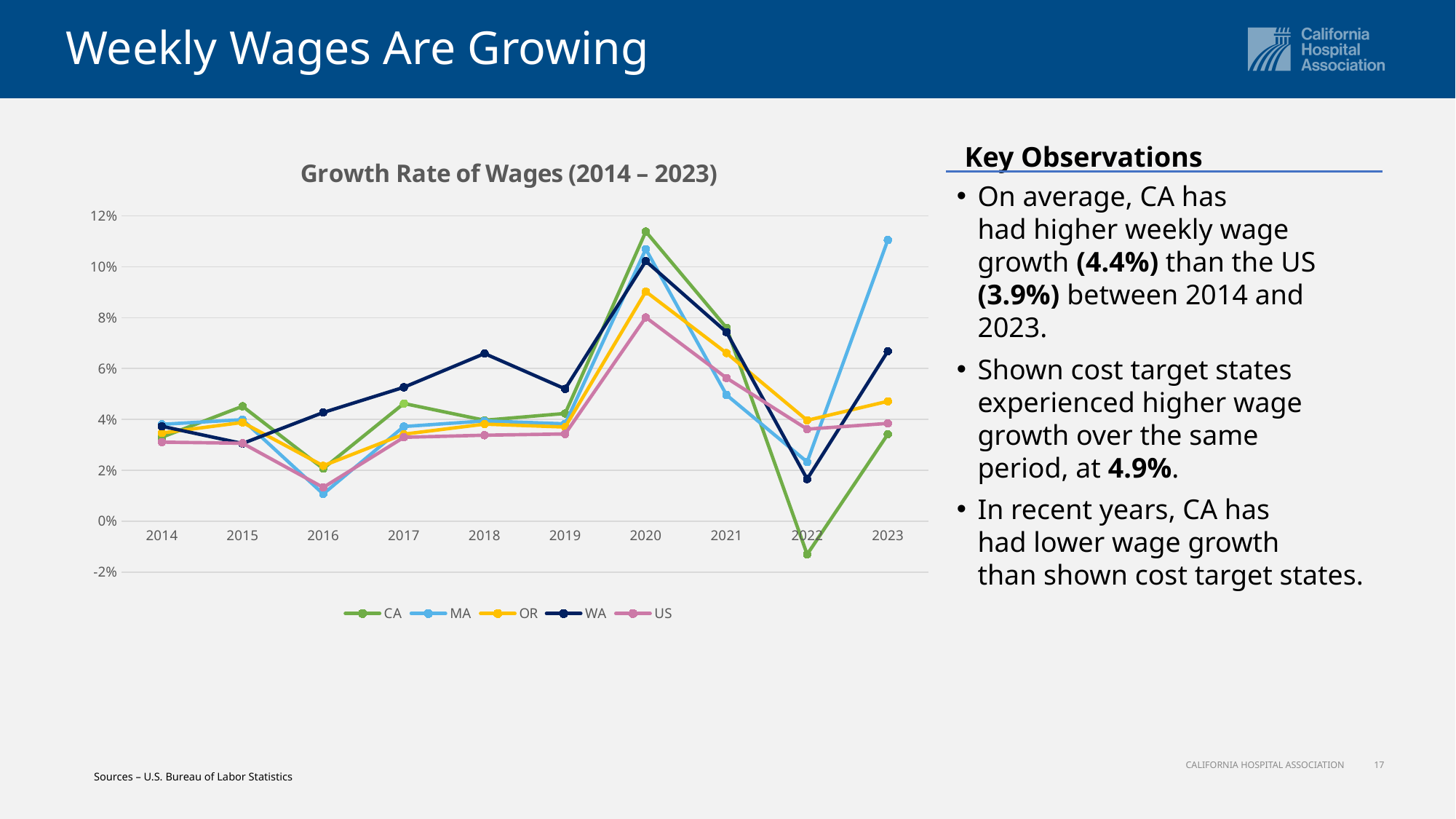
What kind of chart is shown on the slide? Line chart Which series has the highest wage growth rate in 2018? WA Is the value for MA in 2016 greater or less than 2%? less Does the CA line rise or fall from 2020 to 2022? Fall Is the value for CA in 2022 greater or less than 0%? less In 2023, which is larger: the value for MA or the value for CA? MA How many series does the chart's legend list? 5 How many years are plotted along the x axis of the chart? 10 Which series has the lowest wage growth rate in 2022? CA What is the title of the chart? Growth Rate of Wages (2014 – 2023) Is the value for MA in 2023 greater or less than 10%? greater Which series has the highest wage growth rate in 2023? MA